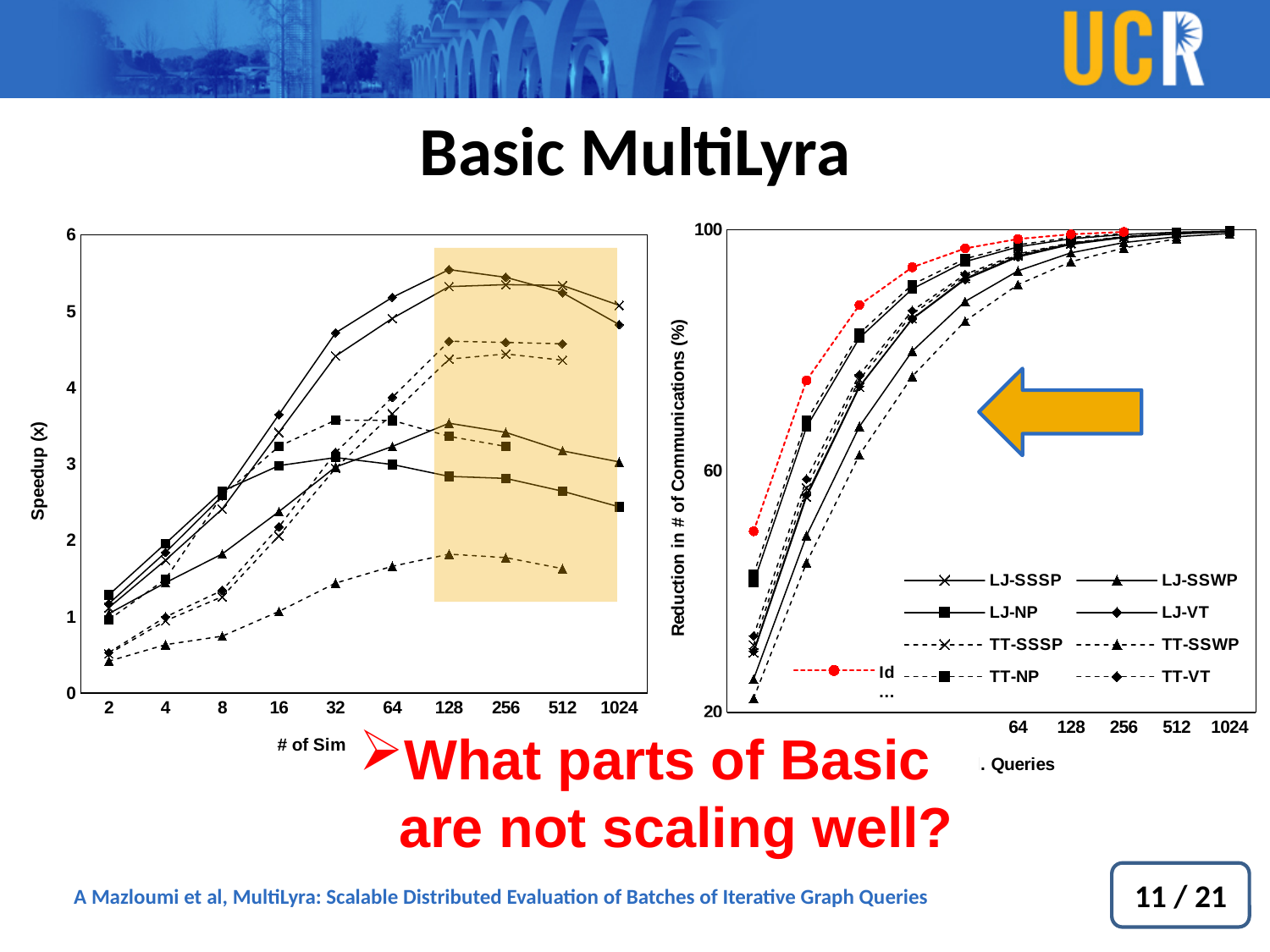
On the left chart, is the lowest speedup value plotted at 2 simultaneous queries greater or less than 1? less On the left chart, is the highest speedup value plotted greater or less than 5? greater What kind of chart is the left chart (Speedup vs # of Sim)? line chart On the right chart, is the value of the Ideal (red) line at 128 queries greater or less than 60? greater What is the y-axis title of the left chart? Speedup (x) What is the y-axis title of the right chart? Reduction in # of Communications (%) What kind of chart is the right chart (Reduction in # of Communications)? line chart How many series does the legend of the right chart list? 9 How many x-axis categories are labelled on the left chart? 10 On the right chart, do the values generally rise or fall as the number of queries increases? rise